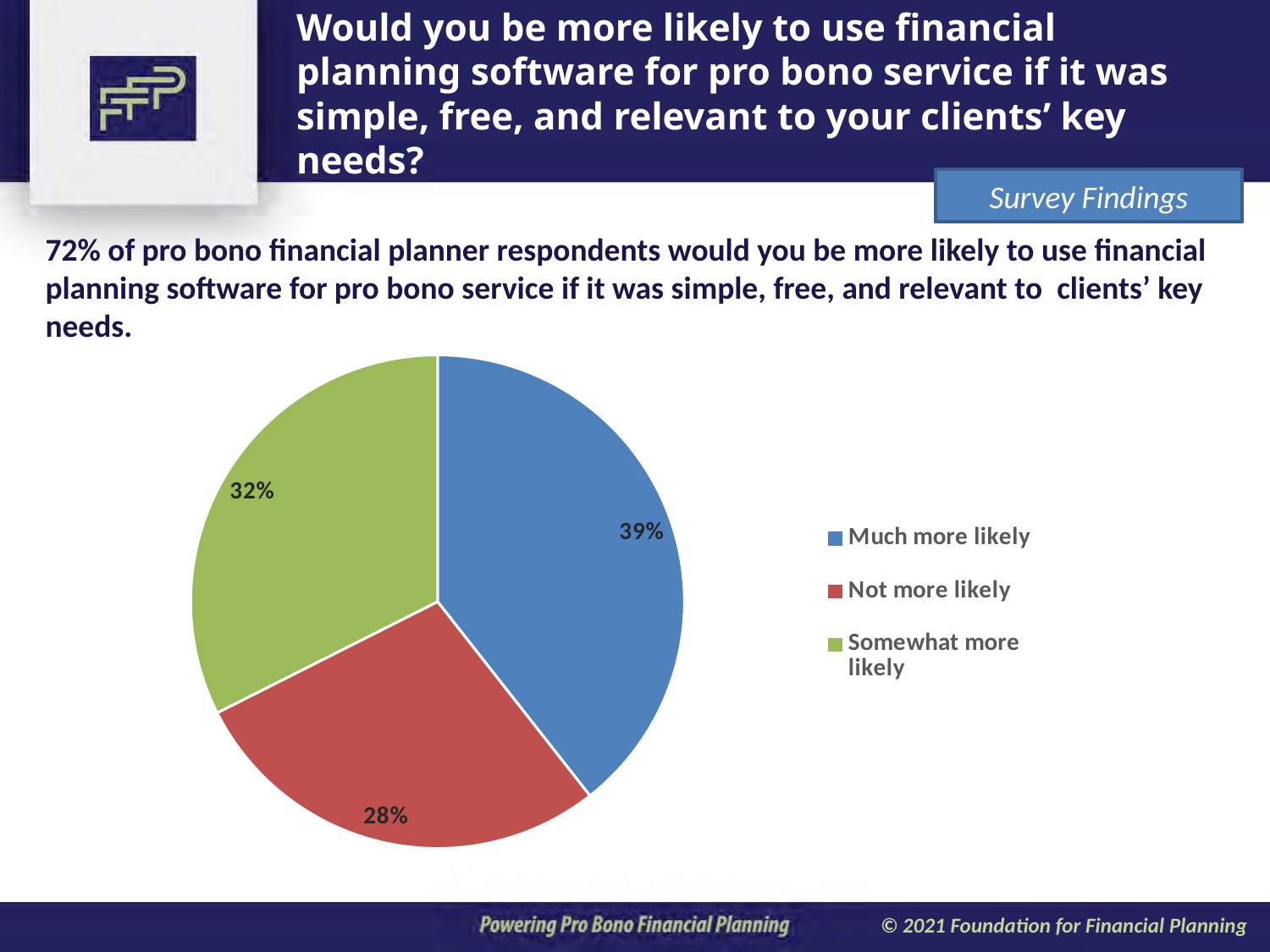
What colour is the "Not more likely" slice? red What kind of chart is shown on the slide? pie chart Which response category has the largest share of the pie? Much more likely What percentage of respondents said "Not more likely"? 28% What percentage of respondents said they would be "Much more likely" to use the software? 39% What is the combined share of "Much more likely" and "Somewhat more likely"? 71% What percentage of respondents said "Somewhat more likely"? 32% Which legend entry is shown in green? Somewhat more likely How many percentage points larger is the "Much more likely" slice than the "Not more likely" slice? 11 How many categories does the pie chart show? 3 Which response category has the smallest share of the pie? Not more likely Which slice is larger: "Somewhat more likely" or "Not more likely"? Somewhat more likely